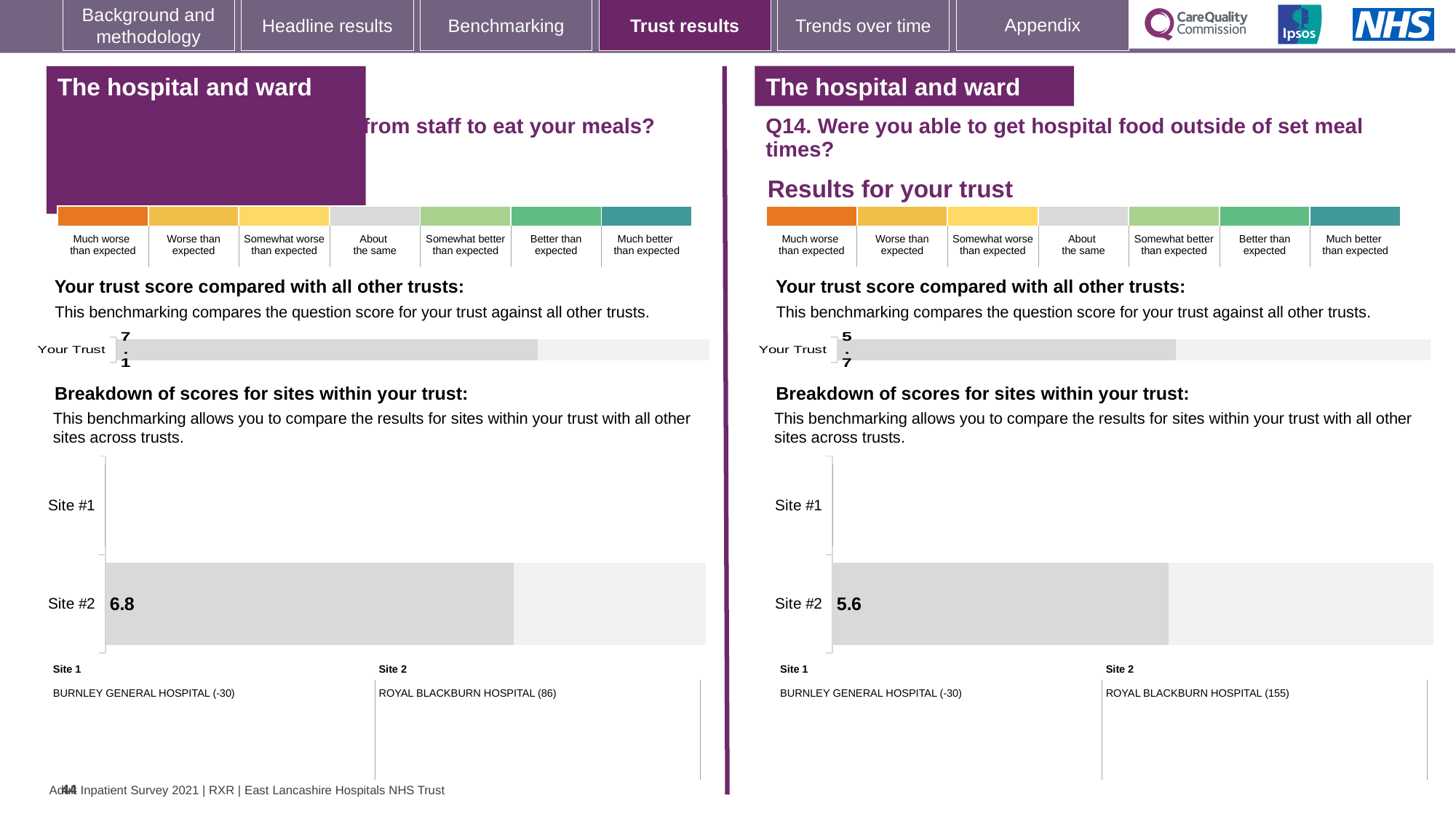
How many sites are listed on the category axis of the left-hand 'Breakdown of scores for sites within your trust' chart? 2 On the right-hand side of the slide (Q14), what is the score shown for Your Trust in the 'Your trust score compared with all other trusts' chart? 5.7 What is the difference between the Your Trust score on the left-hand side of the slide (7.1) and the Your Trust score on the right-hand side (5.7)? 1.4 On the left-hand side of the slide, what is the score shown for Your Trust in the 'Your trust score compared with all other trusts' chart? 7.1 What type of chart is used to show the breakdown of scores for sites within your trust on the right-hand side of the slide? Bar chart Which hospital is listed as Site 2 in the right-hand site breakdown (Q14)? ROYAL BLACKBURN HOSPITAL (155) What is the difference between the Site #2 score on the left-hand side of the slide (6.8) and the Site #2 score on the right-hand side (5.6)? 1.2 In the left-hand 'Breakdown of scores for sites within your trust' chart, what is the score for Site #2? 6.8 Which is larger: the Your Trust score on the left-hand side of the slide or the Your Trust score on the right-hand side (Q14)? Left-hand side (7.1) On the right-hand side of the slide, which is larger: the Your Trust score or the Site #2 score? Your Trust (5.7) How many categories does the colour scale above the right-hand 'Your trust score compared with all other trusts' chart show, from 'Much worse than expected' to 'Much better than expected'? 7 In the right-hand 'Breakdown of scores for sites within your trust' chart (Q14), what is the score for Site #2? 5.6